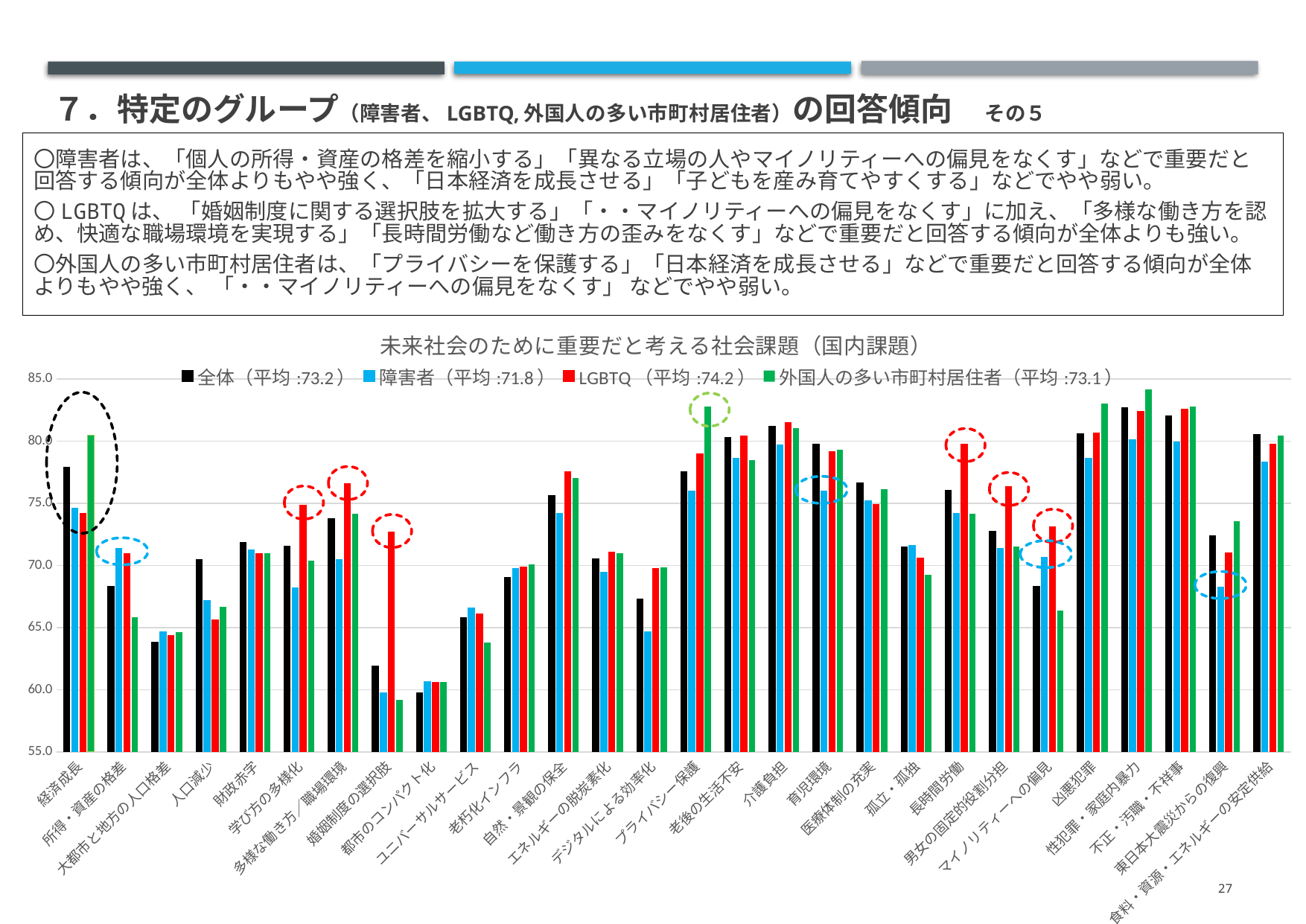
Is the value for 全体 at 大都市と地方の人口格差 greater or less than 65? less At 婚姻制度の選択肢, which is larger: the LGBTQ value or the 障害者 value? LGBTQ What kind of chart is shown on the slide? bar chart At 経済成長, which is larger: the 外国人の多い市町村居住者 value or the 障害者 value? 外国人の多い市町村居住者 According to the legend, what is the average (平均) for the LGBTQ series? 74.2 How many social-issue categories are plotted along the x axis? 28 How many series does the legend list? 4 What is the title of the chart? 未来社会のために重要だと考える社会課題（国内課題） Is the value for 全体 at 都市のコンパクト化 greater or less than 65? less For the 全体 series, which category has the lowest value? 都市のコンパクト化 Is the value for LGBTQ at 婚姻制度の選択肢 greater or less than 70? greater